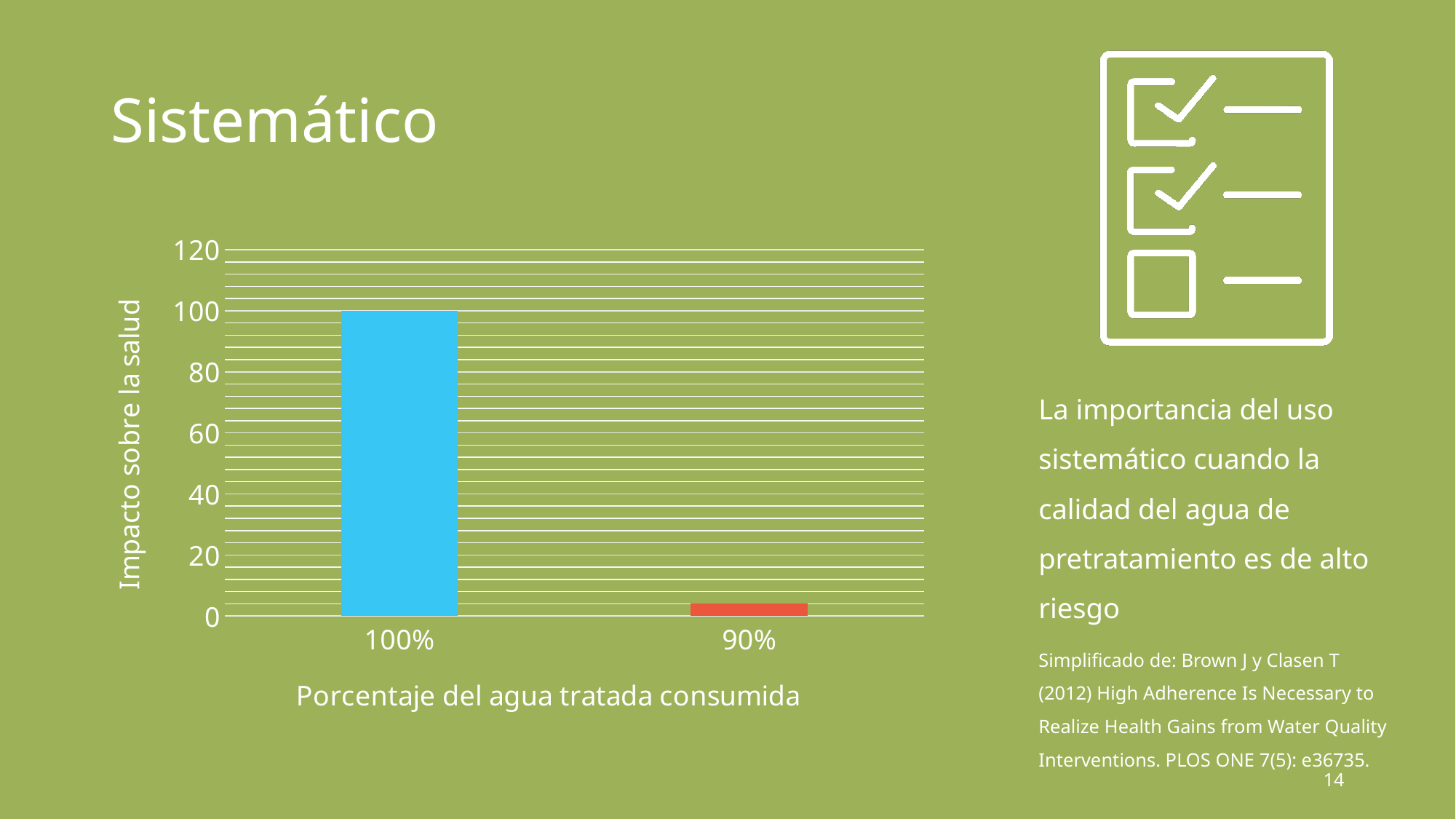
Do the values rise or fall moving from left to right along the x axis? fall Is the value for the 100% category greater or less than 80? greater Which is larger, the value for 100% or the value for 90%? 100% What kind of chart is shown on the slide? bar chart Which category has the lowest value? 90% How many categories are shown on the x axis of the chart? 2 What is the value of the bar for the 100% category? 100 Which category has the highest value? 100% Is the value for the 90% category greater or less than 20? less What is the title of the x axis? Porcentaje del agua tratada consumida What is the title of the y axis? Impacto sobre la salud